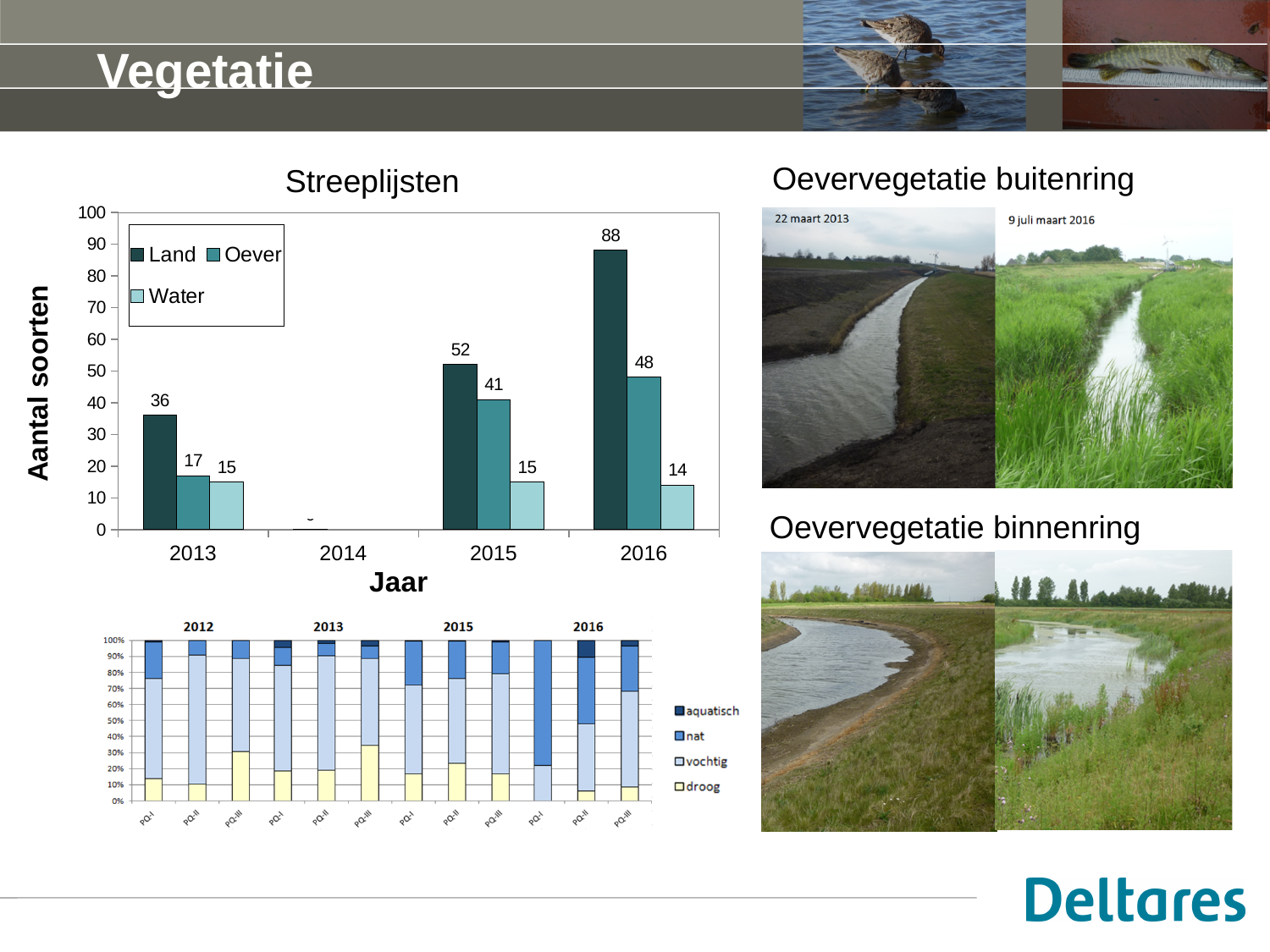
In the Streeplijsten chart, which year has the highest value for Land? 2016 In the Streeplijsten chart, how many series does the legend list? 3 What kind of chart is the Streeplijsten chart? bar chart In the Streeplijsten chart, what is the label of the y axis? Aantal soorten In the stacked chart at the bottom left, what are the four legend entries? aquatisch, nat, vochtig, droog In the Streeplijsten chart, what is the difference between the Land values for 2016 and 2015? 36 In the Streeplijsten chart, what is the value for Land in 2016? 88 In the Streeplijsten chart, which year has the lowest value for Water among the years with labelled bars? 2016 In the stacked chart at the bottom left, how many series does the legend list? 4 In the Streeplijsten chart, which is larger: Oever in 2013 or Water in 2013? Oever in 2013 In the Streeplijsten chart, what is the value for Oever in 2015? 41 In the Streeplijsten chart, what is the value for Water in 2013? 15